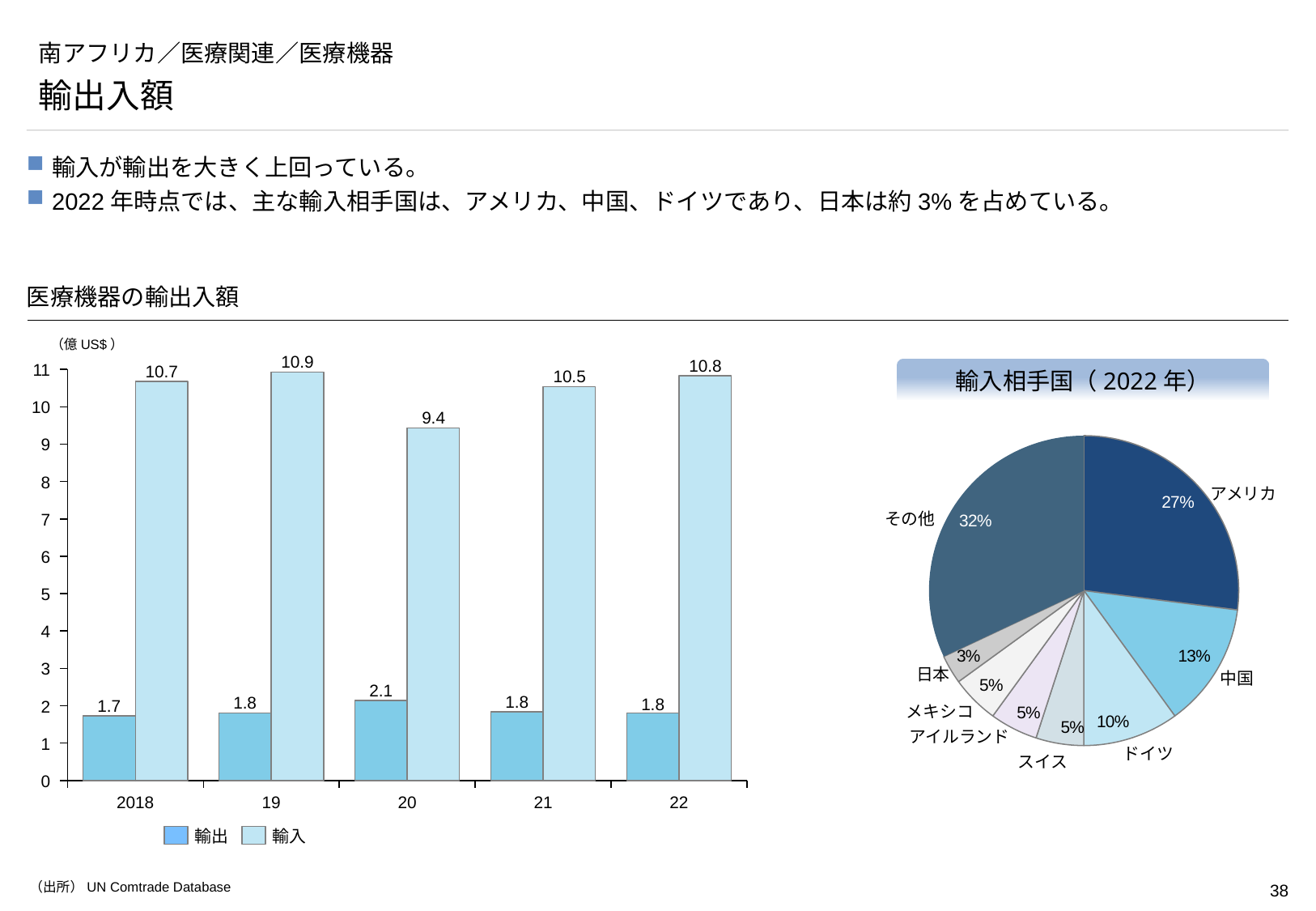
In the bar chart 医療機器の輸出入額, what is the 輸入 value for 2018? 10.7 What kind of chart is 輸入相手国（2022年）? pie chart In the bar chart 医療機器の輸出入額, what is the 輸出 value for 20? 2.1 In the bar chart 医療機器の輸出入額, is the 輸入 value for 20 greater or less than 10? less In the bar chart 医療機器の輸出入額, how many series does the legend list? 2 In the bar chart 医療機器の輸出入額, how many years are shown on the x axis? 5 In the bar chart 医療機器の輸出入額, which year has the highest 輸入 value? 19 In the bar chart 医療機器の輸出入額, what is the difference between 輸入 and 輸出 in 22? 9.0 In the pie chart 輸入相手国（2022年）, what share does アメリカ have? 27% In the pie chart 輸入相手国（2022年）, which is larger, 中国 or ドイツ? 中国 In the pie chart 輸入相手国（2022年）, what share does 日本 have? 3% In the bar chart 医療機器の輸出入額, which year has the lowest 輸入 value? 20